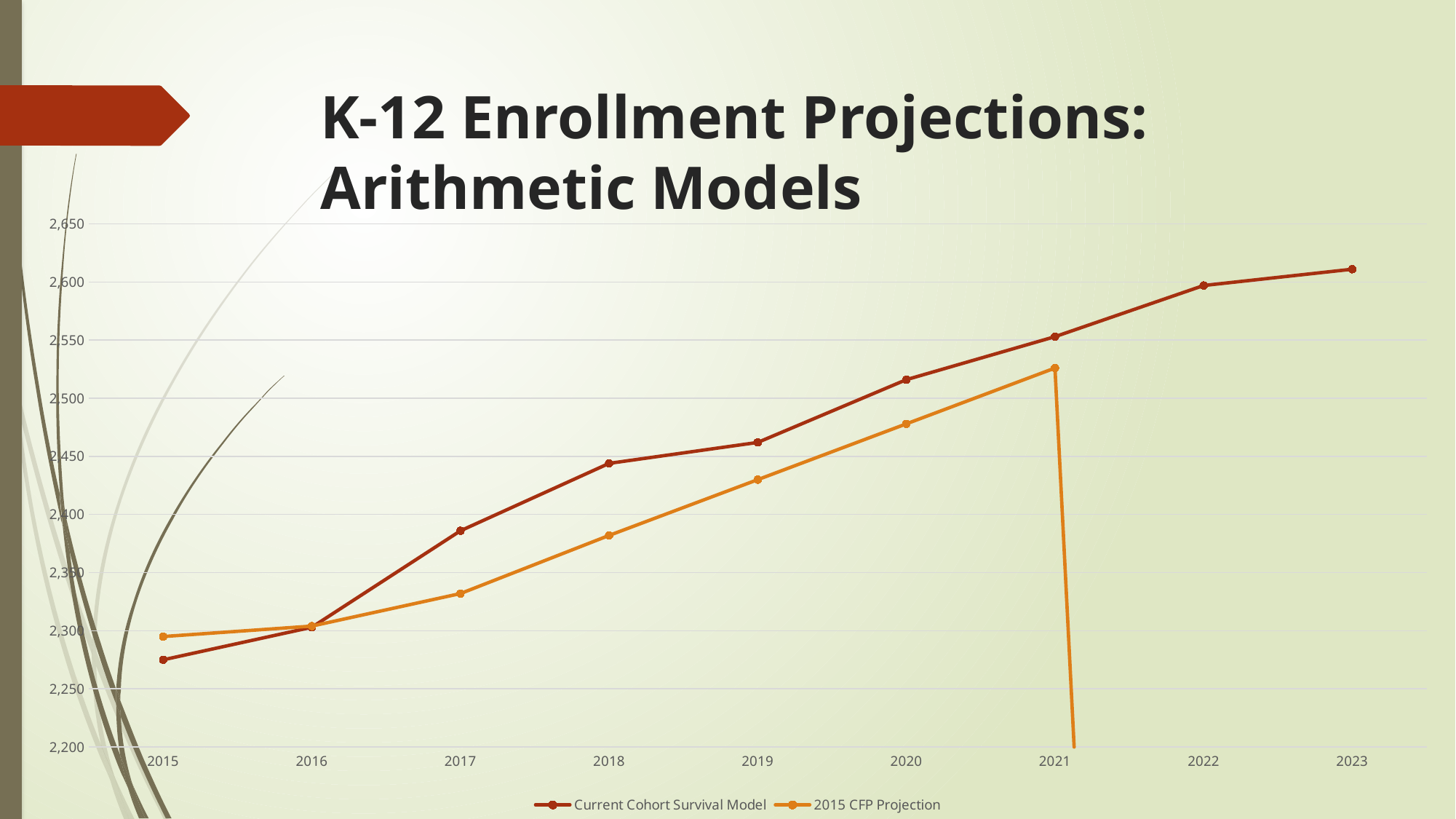
In which year is the Current Cohort Survival Model value lowest? 2015 What is the title of the slide containing the chart? K-12 Enrollment Projections: Arithmetic Models Does the Current Cohort Survival Model line rise or fall from 2015 to 2023? Rise How many series does the legend list? 2 What kind of chart is shown on the slide? Line chart In 2019, which series has the larger value: Current Cohort Survival Model or 2015 CFP Projection? Current Cohort Survival Model How many years are shown on the x axis? 9 Is the Current Cohort Survival Model value for 2023 greater or less than 2,600? greater Is the 2015 CFP Projection value for 2018 greater or less than 2,400? less Is the Current Cohort Survival Model value for 2015 greater or less than 2,300? less In which year is the Current Cohort Survival Model value highest? 2023 In 2015, which series has the larger value: Current Cohort Survival Model or 2015 CFP Projection? 2015 CFP Projection